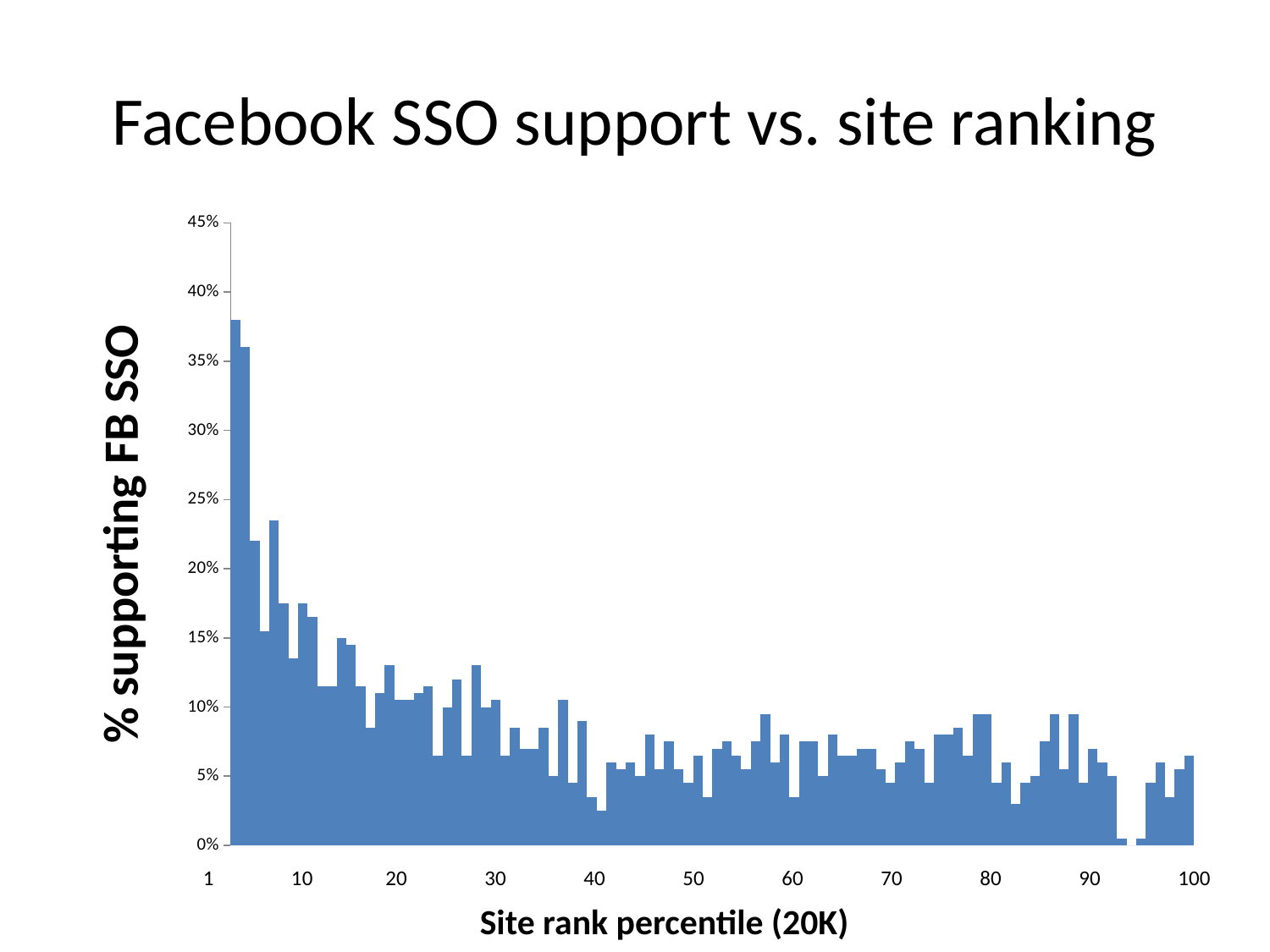
What is the label of the x axis? Site rank percentile (20K) Which has a larger % supporting FB SSO: site rank percentile 1 or site rank percentile 100? 1 Is the value for site rank percentile 50 greater or less than 10%? less Overall, do the values rise or fall as the site rank percentile increases from 1 to 100? fall Is the value for site rank percentile 1 greater or less than 35%? greater Is the value for site rank percentile 20 greater or less than 15%? less What kind of chart is shown on the slide? bar chart What is the title of the chart? Facebook SSO support vs. site ranking Which site rank percentile has the highest % supporting FB SSO? 1 Which has a larger % supporting FB SSO: site rank percentile 10 or site rank percentile 60? 10